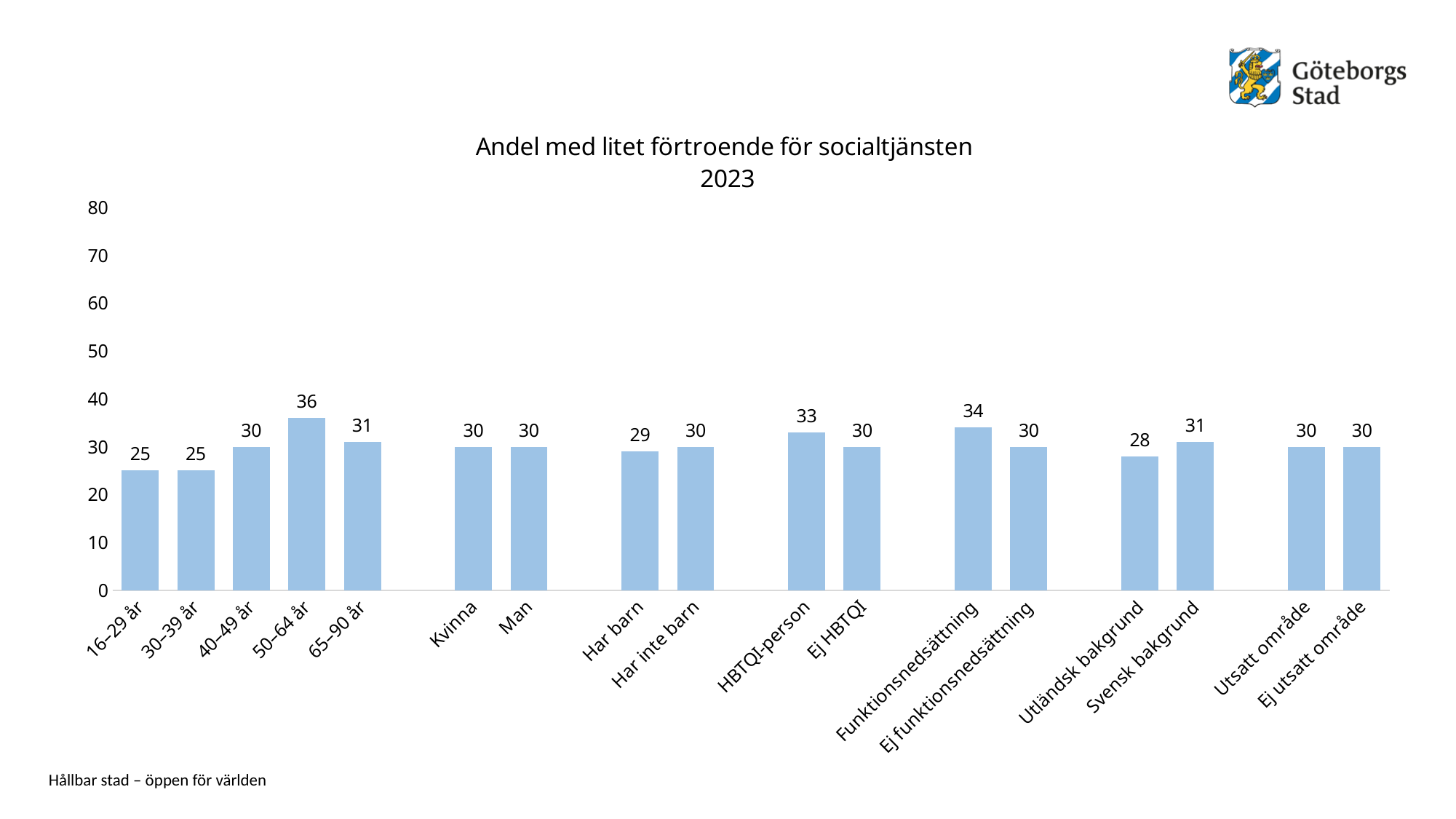
Is the value for 50–64 år greater or less than 40? less What is the value for Funktionsnedsättning? 34 What is the value for Utländsk bakgrund? 28 How many categories are shown on the x axis? 17 What kind of chart is shown on the slide? bar chart What is the value for HBTQI-person? 33 What is the value for 50–64 år? 36 Which is larger, the value for Har barn or the value for Har inte barn? Har inte barn What is the difference between the values for 50–64 år and 16–29 år? 11 Which category has the highest value? 50–64 år What is the difference between the values for Funktionsnedsättning and Ej funktionsnedsättning? 4 Which is larger, the value for Utländsk bakgrund or the value for Svensk bakgrund? Svensk bakgrund